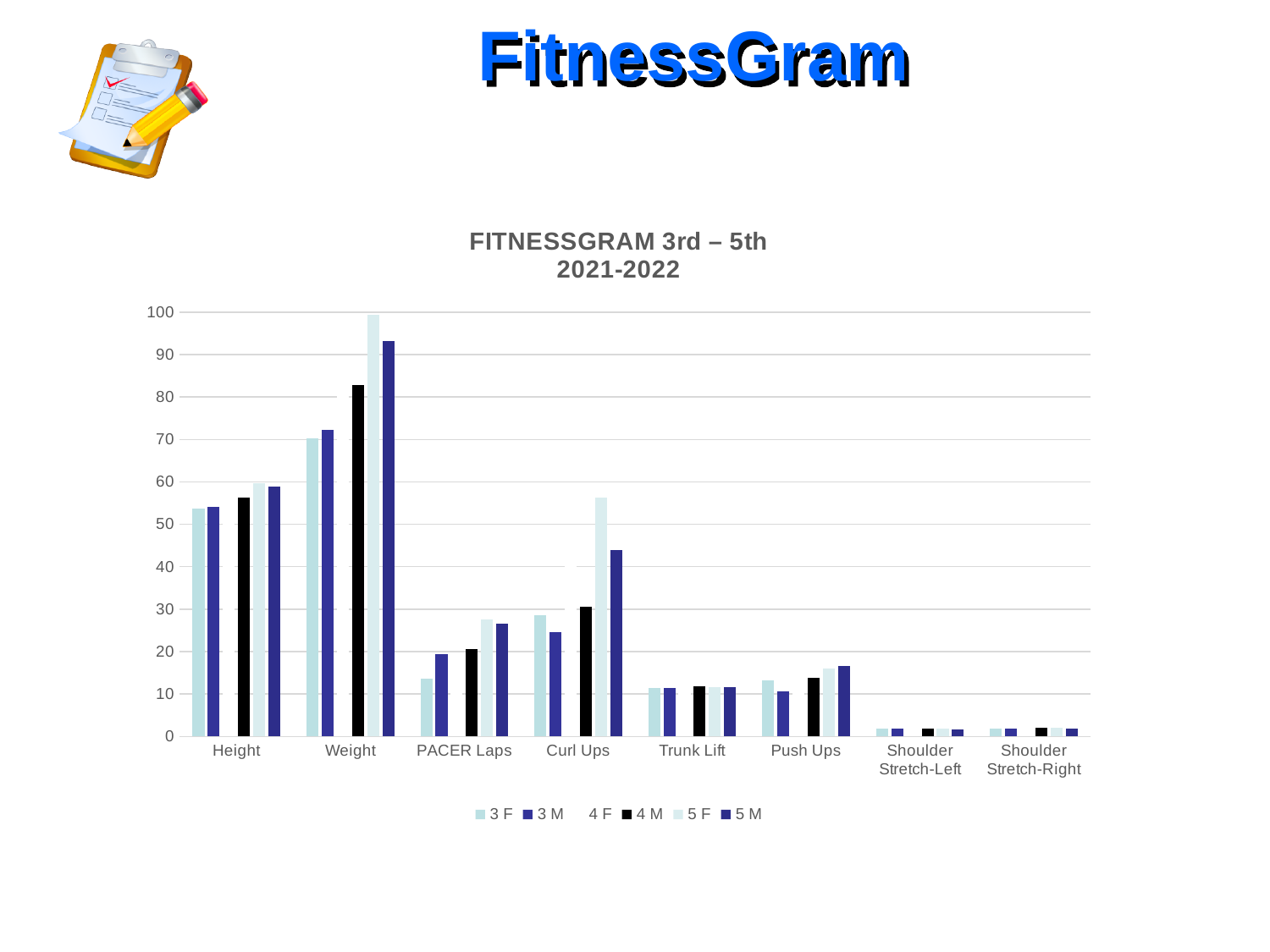
Which category contains the tallest bar in the chart? Weight In the Curl Ups category, which is larger: the 5 F bar or the 5 M bar? 5 F Is the value for 5 F in the Curl Ups category greater or less than 50? greater Is the value for 4 M in the Weight category greater or less than 90? less Within the Weight category, which series has the highest bar? 5 F Is the value for 5 F in the Weight category greater or less than 90? greater How many categories are shown along the x axis of the FITNESSGRAM chart? 8 In the Weight category, which is larger: the 4 M bar or the 3 M bar? 4 M What kind of chart is shown on the slide? bar chart How many series does the legend of the FITNESSGRAM chart list? 6 What is the title of the chart on the slide? FITNESSGRAM 3rd – 5th 2021-2022